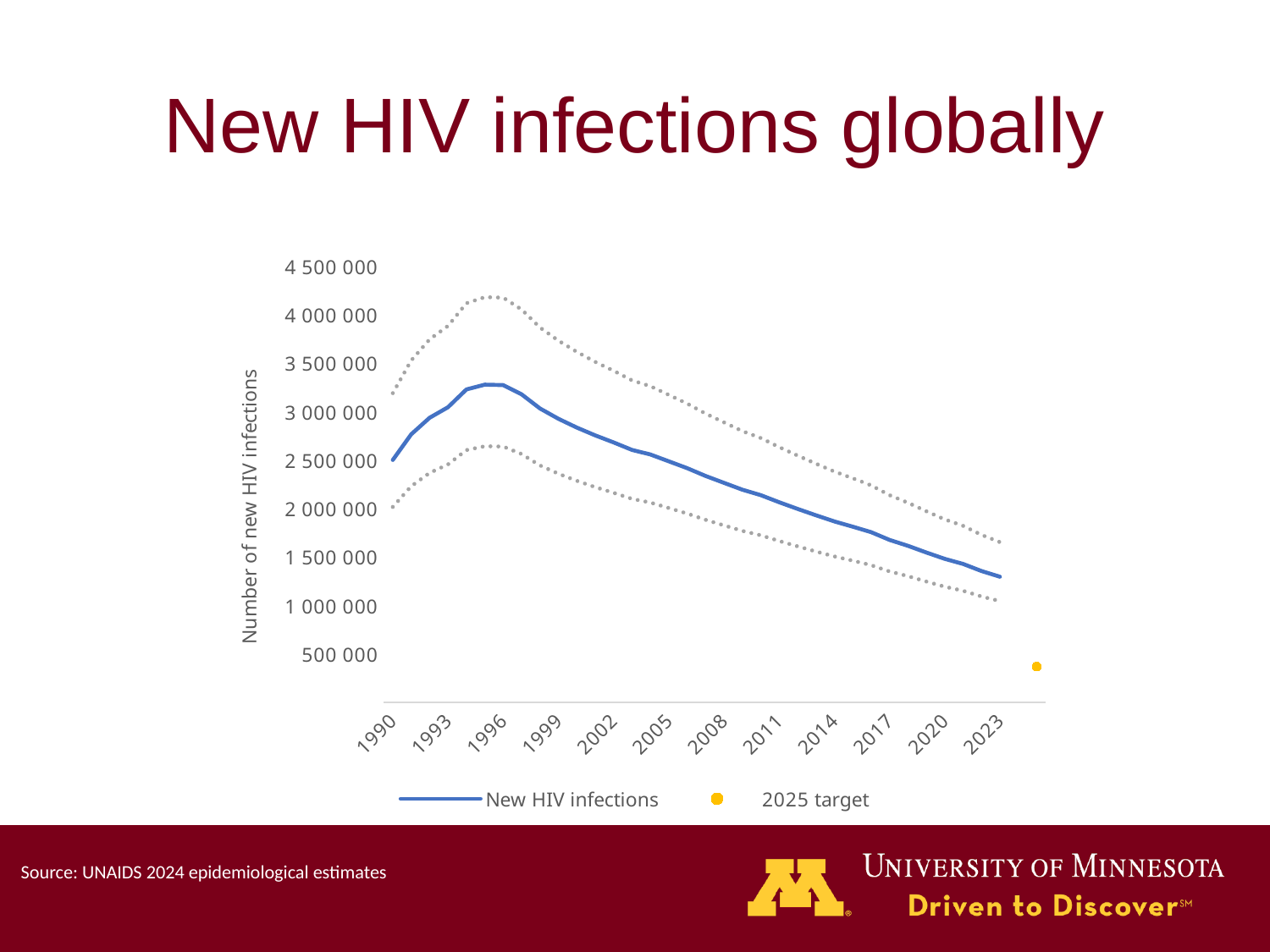
Is the value for new HIV infections in 2008 greater or less than 2 000 000? greater Do new HIV infections rise or fall between 1990 and 1996? rise Is the 2025 target value greater or less than 500 000? less Is the value for new HIV infections in 2023 greater or less than 1 000 000? greater How many entries does the chart legend list? 2 What is the title of the chart? New HIV infections globally What kind of chart is shown on the slide? line chart Which year has more new HIV infections, 1990 or 2023? 1990 What is the label on the vertical axis? Number of new HIV infections How many year labels are shown on the x axis? 12 Do new HIV infections rise or fall between 1996 and 2023? fall